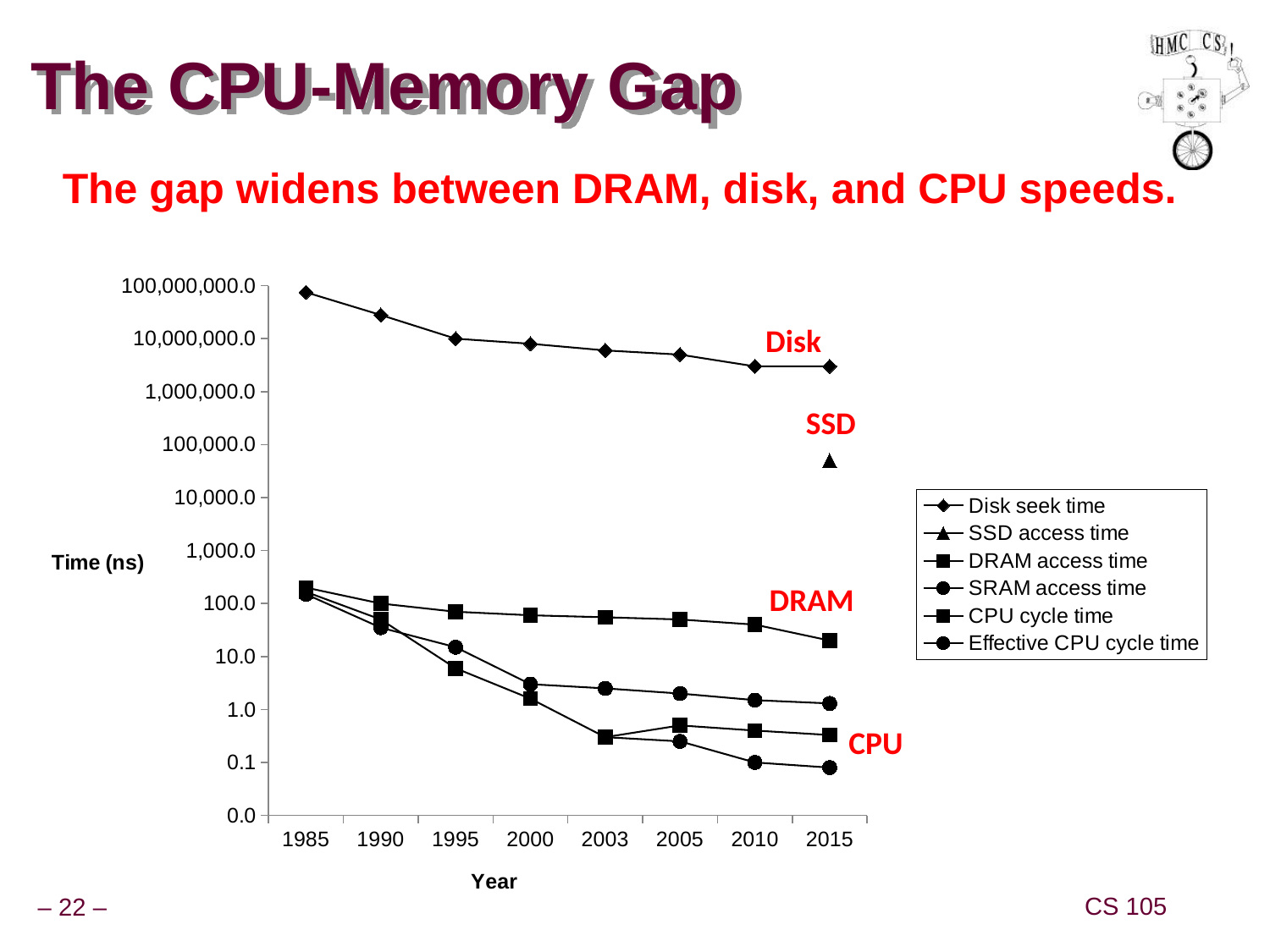
Is the Disk seek time in 2015 greater or less than 10,000,000.0? less Is the DRAM access time in 2015 greater or less than 100.0? less Does the Disk seek time rise or fall from 1985 to 2015? fall What is the label on the y axis? Time (ns) How many years are marked on the x axis? 8 How many series does the legend list? 6 Which series has the highest value in 2015? Disk seek time In 2015, which is larger: Disk seek time or DRAM access time? Disk seek time Is the SSD access time in 2015 greater or less than 10,000.0? greater What kind of chart is shown on the slide? line chart Which series has only a single plotted point? SSD access time